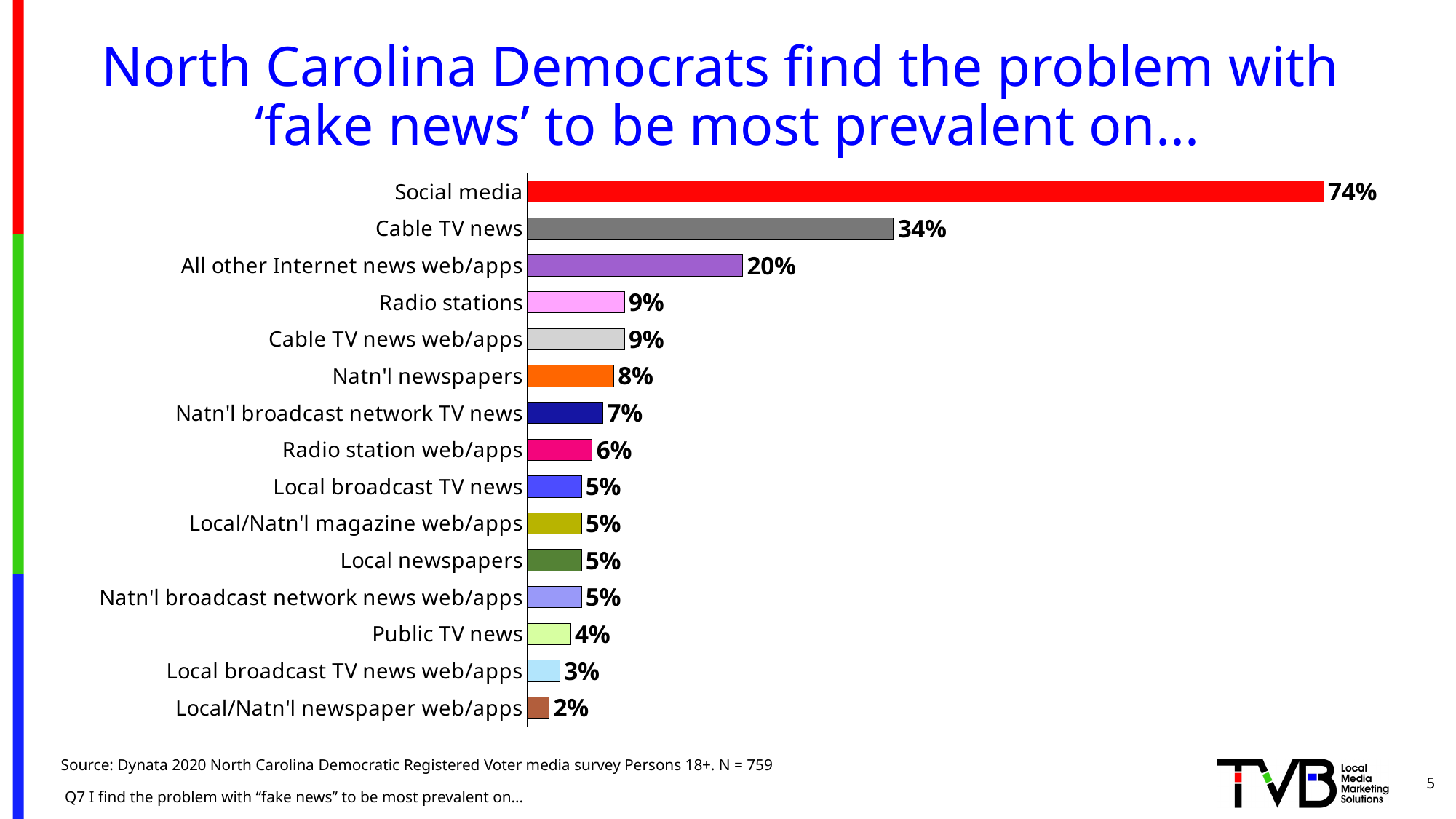
What percentage of North Carolina Democrats find the problem with 'fake news' to be most prevalent on social media? 74% What is the difference between the values for Social media and Cable TV news? 40% What kind of chart is shown on the slide? Bar chart What is the value shown for Public TV news? 4% Which has a larger value, Natn'l newspapers or Radio station web/apps? Natn'l newspapers What is the value shown for All other Internet news web/apps? 20% Which category has the lowest value? Local/Natn'l newspaper web/apps What is the difference between the values for Cable TV news and All other Internet news web/apps? 14% What is the value shown for Cable TV news? 34% How many categories are shown in the chart? 15 Which category has the highest value? Social media What colour is the bar for Social media? Red